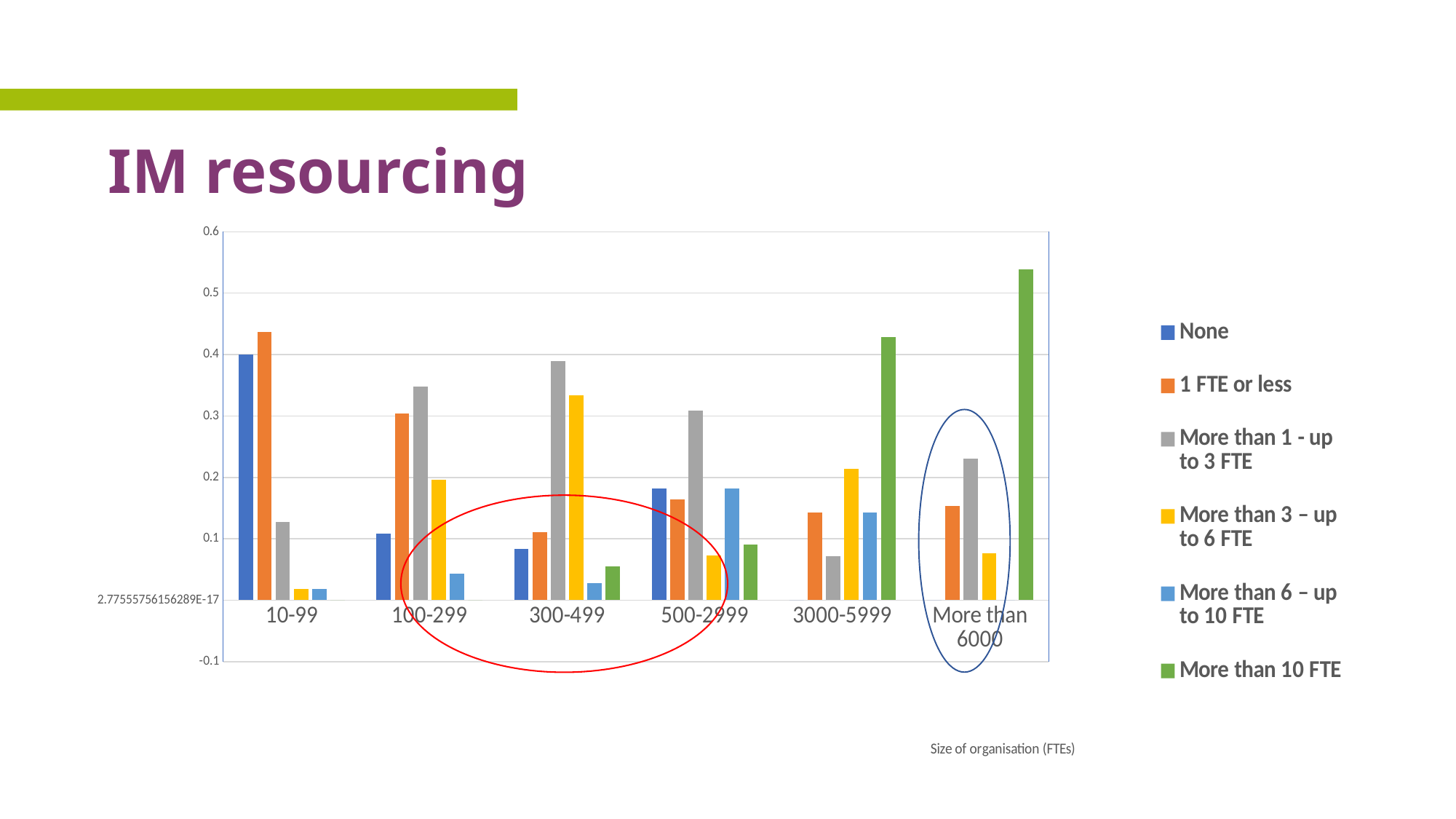
Is the value for 'More than 10 FTE' in the 'More than 6000' category greater or less than 0.5? greater Within the 300-499 category, which series has the tallest bar? More than 1 - up to 3 FTE Is the value for 'None' in the 10-99 category greater or less than 0.3? greater How many series does the legend list? 6 How many organisation size categories are shown on the x axis? 6 Do the values for 'More than 10 FTE' generally rise or fall as organisation size increases along the x axis? rise What is the label on the x axis of the chart? Size of organisation (FTEs) What kind of chart is shown on the slide? bar chart Which organisation size category has the tallest bar for 'None'? 10-99 Which organisation size category has the tallest bar for 'More than 10 FTE'? More than 6000 In the 300-499 category, which is larger: the 'None' bar or the 'More than 1 - up to 3 FTE' bar? More than 1 - up to 3 FTE Is the value for 'More than 3 – up to 6 FTE' in the 100-299 category greater or less than 0.1? greater